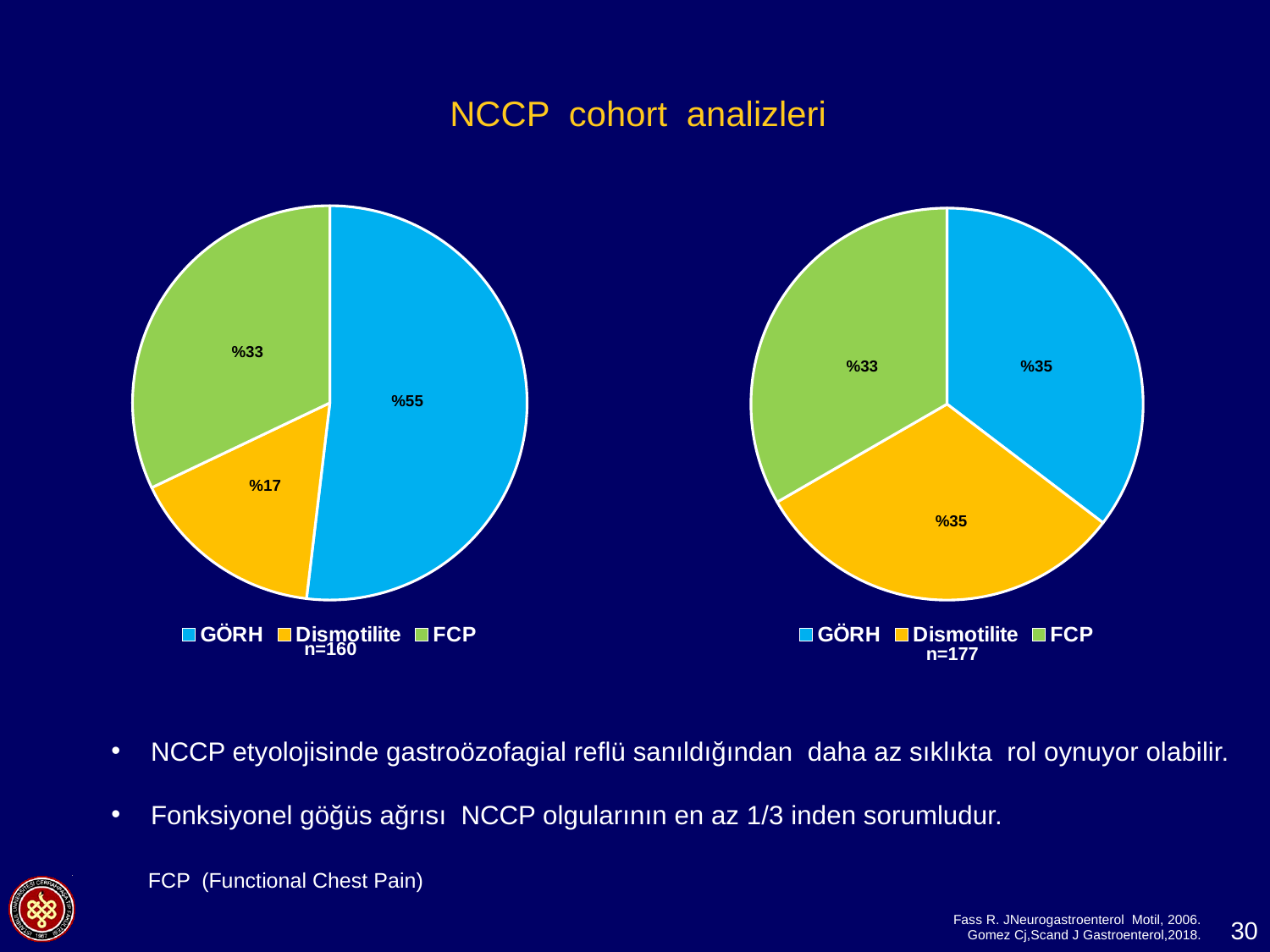
How many entries does the legend of the left pie chart (n=160) list? 3 In the right pie chart (n=177), what is the value for GÖRH? %35 In the left pie chart (n=160), which category has the smallest slice? Dismotilite How many categories does the right pie chart (n=177) show? 3 In the left pie chart (n=160), what is the value for GÖRH? %55 In the right pie chart (n=177), what is the value for FCP? %33 In the right pie chart (n=177), what colour is the Dismotilite slice? yellow In the left pie chart (n=160), what is the difference between the GÖRH and FCP values? %22 What type of chart is the left chart (n=160)? pie chart In the left pie chart (n=160), which category has the largest slice? GÖRH In the left pie chart (n=160), what is the value for Dismotilite? %17